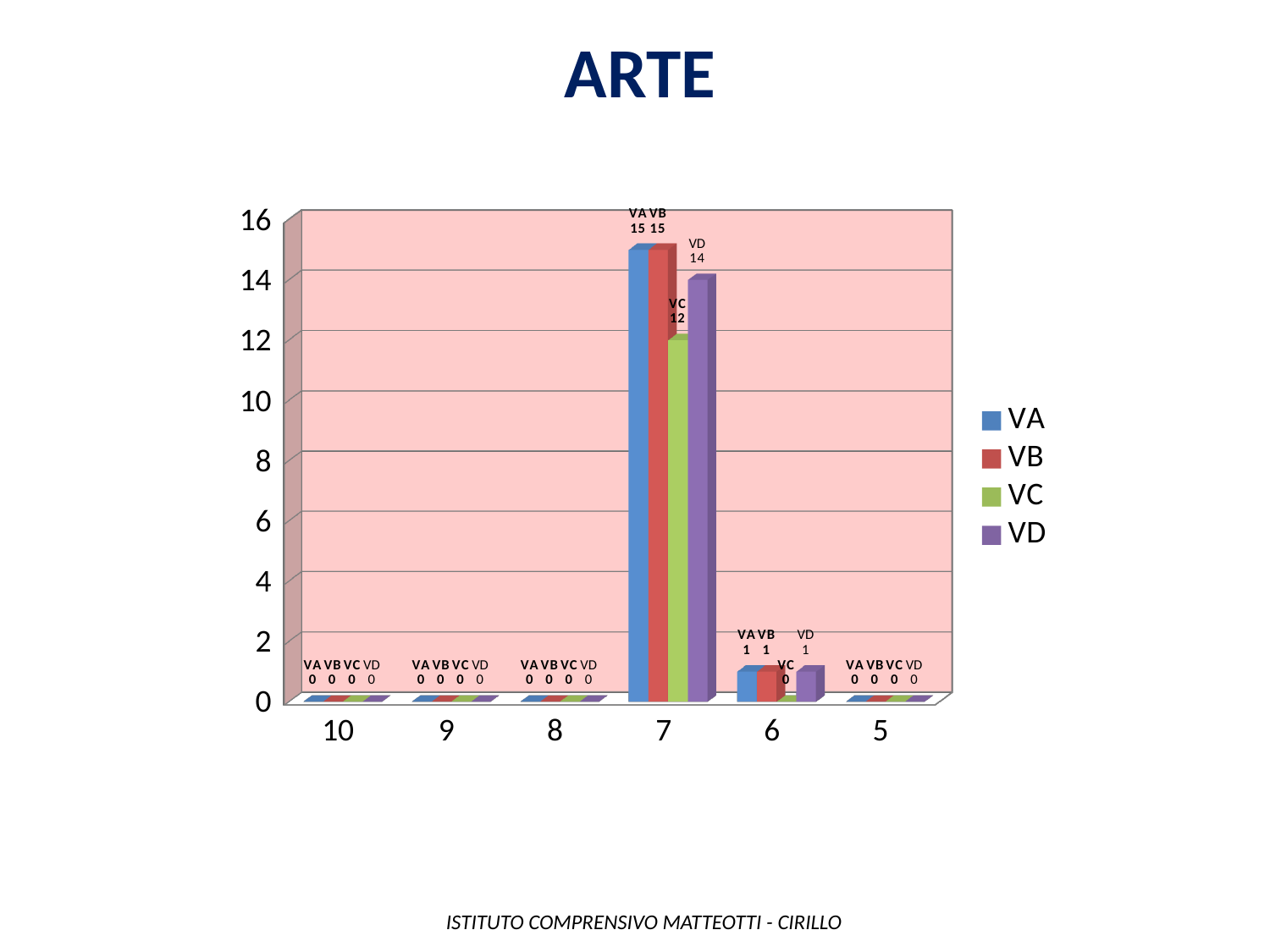
What is the value for VA at category 7? 15 At category 7, which is larger: the VD value or the VC value? VD What is the value for VB at category 6? 1 What is the value for VC at category 6? 0 What kind of chart is shown on the slide? bar chart How many series does the legend list? 4 What is the value for VD at category 7? 14 What is the title of the chart? ARTE Which category has the highest value for VD? 7 What is the value for VC at category 7? 12 How many categories are shown on the x axis? 6 What is the difference between the VA value and the VC value at category 7? 3